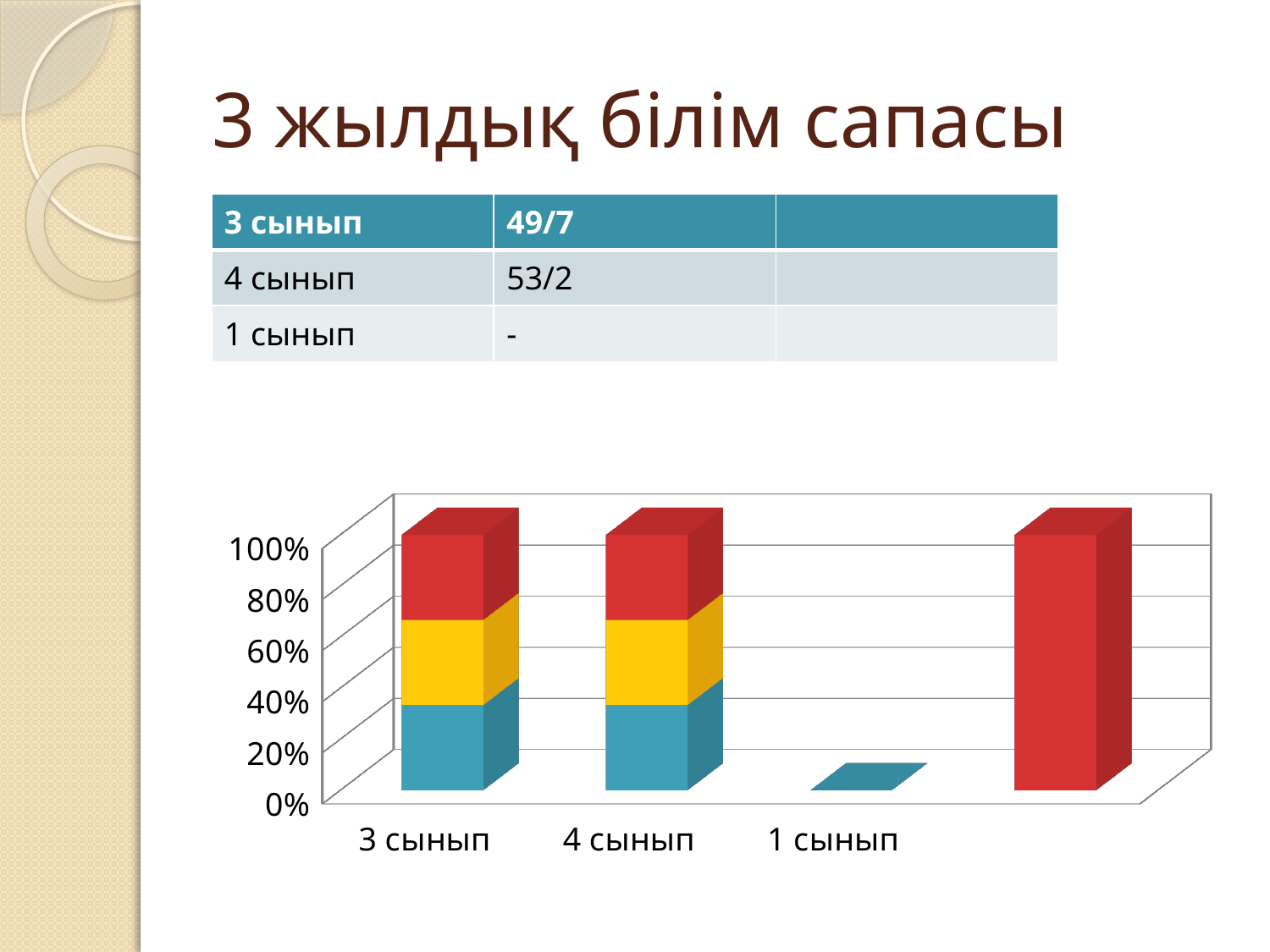
What kind of chart is shown on the slide? bar chart Which labelled category has the lowest bar on the chart? 1 сынып How many categories are labelled on the x axis of the chart? 3 What is the total height of the stacked bar for 4 сынып? 100% What is the highest value shown on the chart's vertical axis? 100% Is the value for 1 сынып greater or less than 20%? less What is the total height of the stacked bar for 3 сынып? 100% How many different colours of segments are used in the stacked bars? 3 What is the title of the slide containing the chart? 3 жылдық білім сапасы Which is taller, the bar for 3 сынып or the bar for 1 сынып? 3 сынып